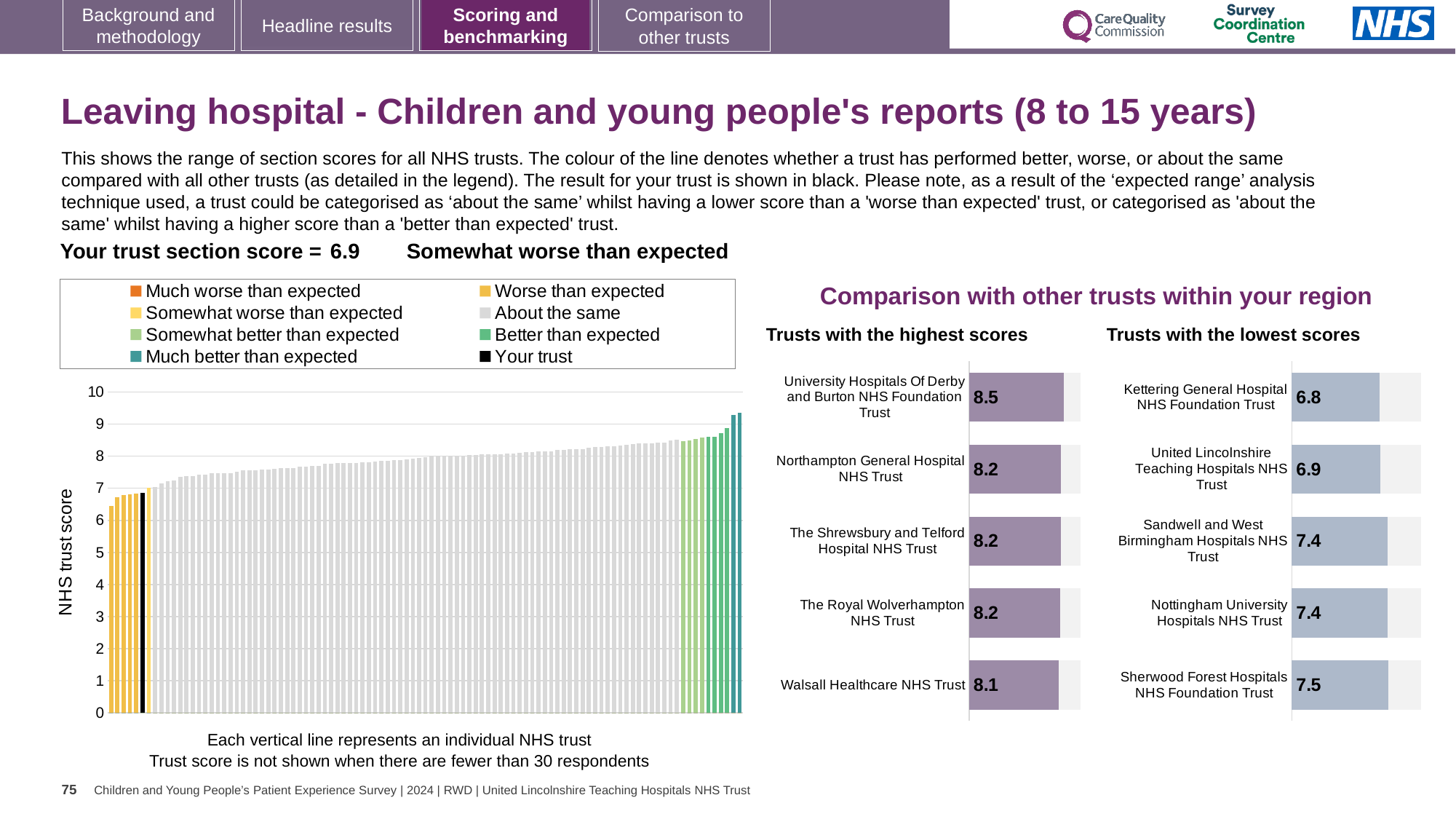
In the 'Trusts with the lowest scores' chart, what is the difference between the scores of Sherwood Forest Hospitals NHS Foundation Trust and Kettering General Hospital NHS Foundation Trust? 0.7 In the 'Trusts with the lowest scores' chart, how many trusts are listed? 5 In the large chart on the left showing NHS trust scores, what is the score for your trust (the black bar)? 6.9 In the large chart on the left showing NHS trust scores, is the value of the highest (rightmost) bar greater or less than 9? greater In the 'Trusts with the highest scores' chart, what is the difference between the scores of University Hospitals Of Derby and Burton NHS Foundation Trust and Walsall Healthcare NHS Trust? 0.4 In the 'Trusts with the lowest scores' chart, which has the larger score: Sherwood Forest Hospitals NHS Foundation Trust or Kettering General Hospital NHS Foundation Trust? Sherwood Forest Hospitals NHS Foundation Trust In the 'Trusts with the highest scores' chart, what is the score for University Hospitals Of Derby and Burton NHS Foundation Trust? 8.5 How many entries does the legend of the large chart on the left list? 8 In the large chart on the left showing NHS trust scores, do the values rise or fall from left to right? rise In the 'Trusts with the lowest scores' chart, what is the score for Kettering General Hospital NHS Foundation Trust? 6.8 In the 'Trusts with the highest scores' chart, which trust has the highest score? University Hospitals Of Derby and Burton NHS Foundation Trust In the 'Trusts with the lowest scores' chart, which trust has the lowest score? Kettering General Hospital NHS Foundation Trust